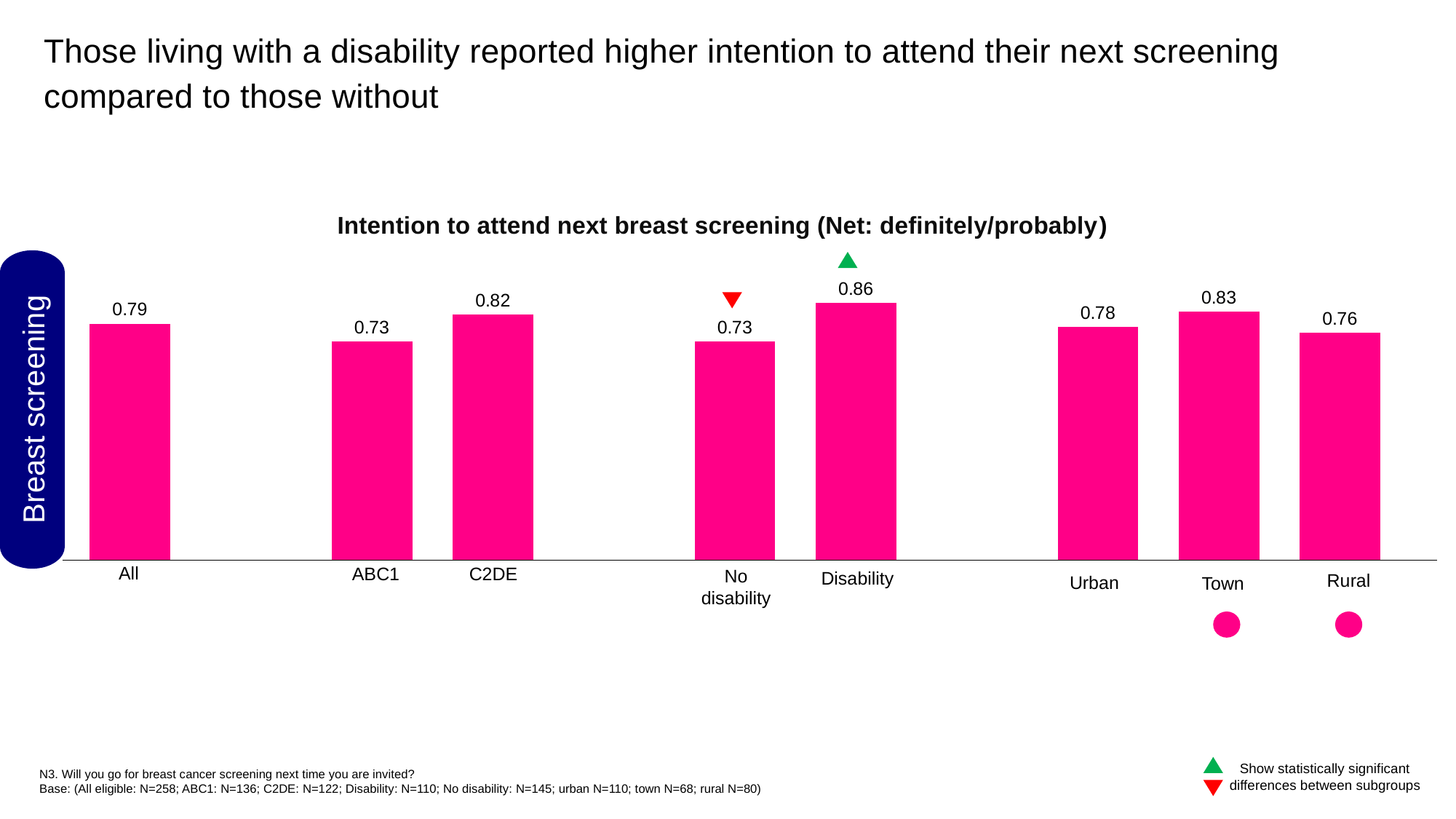
What is the value for Disability? 0.86 What kind of chart is shown? Bar chart What is the difference between the values for C2DE and ABC1? 0.09 Which category has the highest value? Disability What is the value for Rural? 0.76 Which is larger, the value for ABC1 or the value for C2DE? C2DE What is the value for Town? 0.83 What is the title of the chart? Intention to attend next breast screening (Net: definitely/probably) Which is larger, the value for Town or the value for Urban? Town What is the difference between the values for Disability and No disability? 0.13 How many categories are plotted in the chart? 8 What is the value for All? 0.79